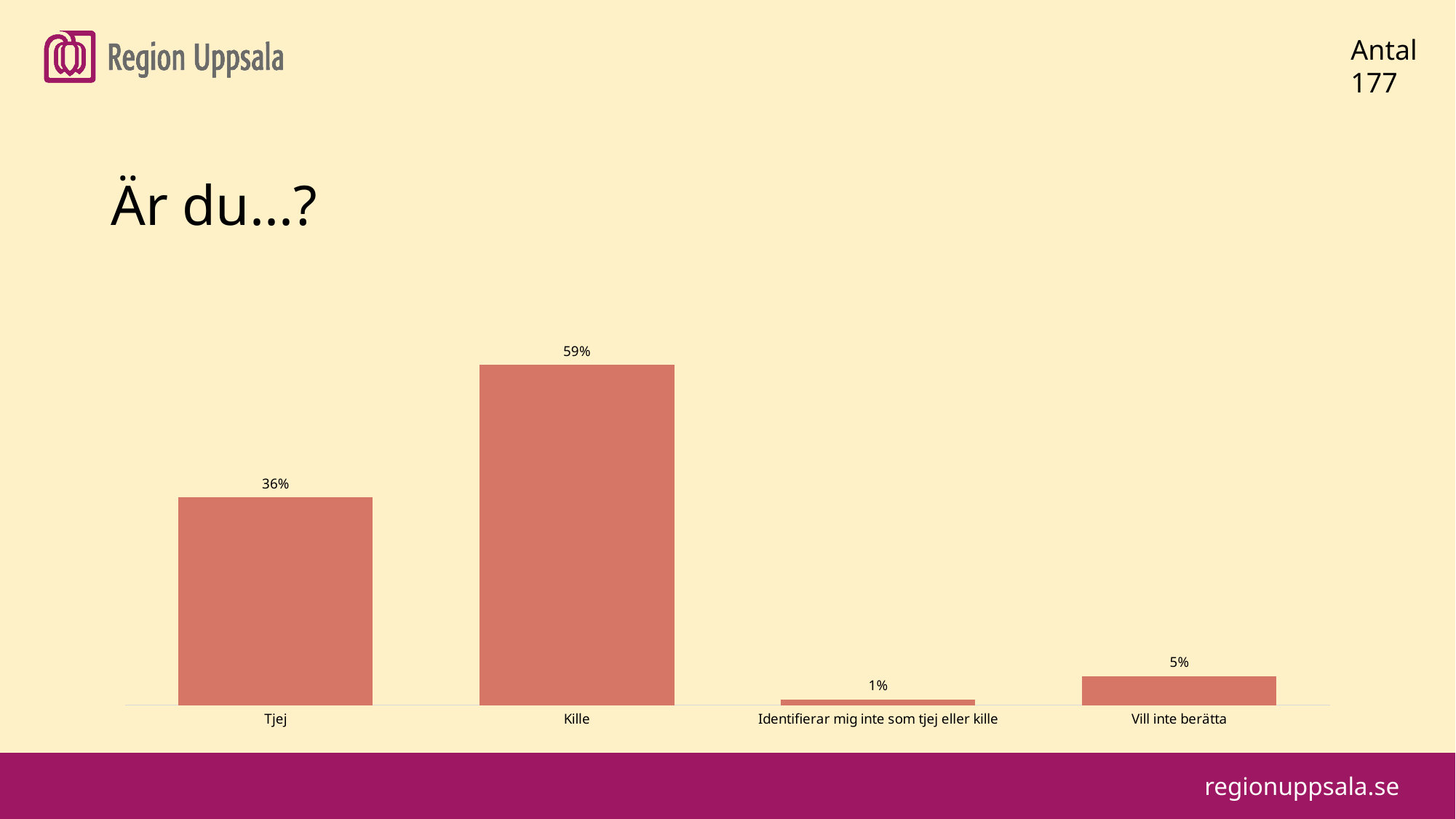
What is the value for Kille? 59% What kind of chart is shown on the slide? Bar chart What is the difference between the values for Vill inte berätta and Identifierar mig inte som tjej eller kille? 4% What is the value for Vill inte berätta? 5% Which category has the lowest value? Identifierar mig inte som tjej eller kille What is the title of the slide containing the chart? Är du...? What is the value for Identifierar mig inte som tjej eller kille? 1% Which is larger, the value for Tjej or the value for Vill inte berätta? Tjej Which category has the highest value? Kille What is the difference between the values for Kille and Tjej? 23% How many categories are shown in the chart? 4 What is the value for Tjej? 36%